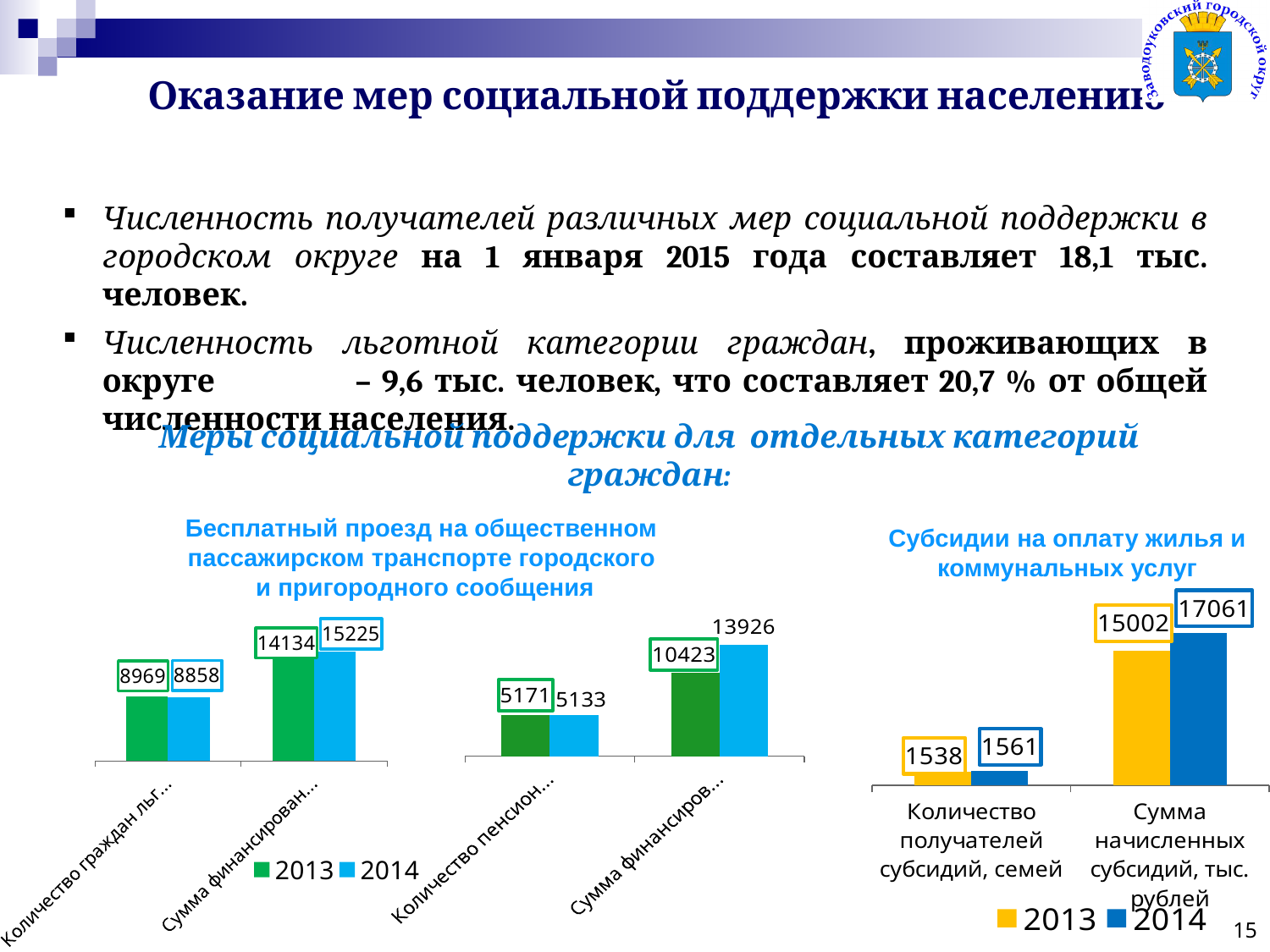
On the middle chart at the bottom of the slide, what is the difference between the 2014 and 2013 values for the second category ('Сумма финансиров...')? 3503 What kind of chart is the chart titled 'Субсидии на оплату жилья и коммунальных услуг'? Bar chart On the chart titled 'Субсидии на оплату жилья и коммунальных услуг', what is the 2014 value for 'Сумма начисленных субсидий, тыс. рублей'? 17061 On the chart titled 'Бесплатный проезд на общественном пассажирском транспорте городского и пригородного сообщения', what is the 2014 value for the second category ('Сумма финансирован...')? 15225 On the middle chart at the bottom of the slide, what is the 2014 value for the second category ('Сумма финансиров...')? 13926 On the chart titled 'Субсидии на оплату жилья и коммунальных услуг', which year has the larger value for 'Количество получателей субсидий, семей'? 2014 On the chart titled 'Субсидии на оплату жилья и коммунальных услуг', how many series does the legend list? 2 On the chart titled 'Бесплатный проезд на общественном пассажирском транспорте городского и пригородного сообщения', what is the 2013 value for the first category ('Количество граждан льг...')? 8969 On the chart titled 'Бесплатный проезд на общественном пассажирском транспорте городского и пригородного сообщения', what is the difference between the 2013 and 2014 values for the first category ('Количество граждан льг...')? 111 On the chart titled 'Субсидии на оплату жилья и коммунальных услуг', what is the difference between the 2014 and 2013 values for 'Сумма начисленных субсидий, тыс. рублей'? 2059 On the middle chart at the bottom of the slide, what is the 2013 value for the first category ('Количество пенсион...')? 5171 On the chart titled 'Субсидии на оплату жилья и коммунальных услуг', what is the 2013 value for 'Количество получателей субсидий, семей'? 1538